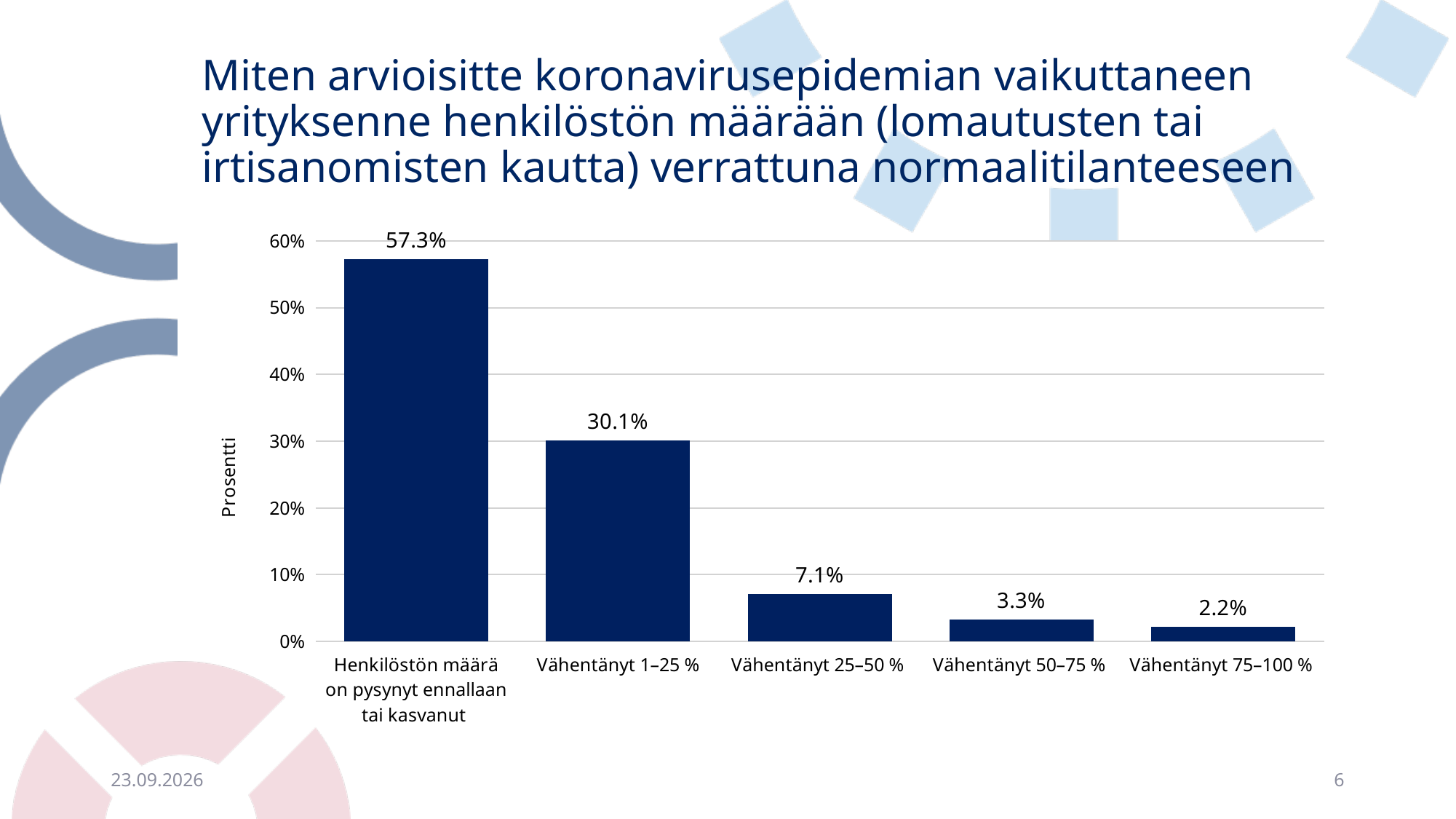
What is the label of the vertical axis? Prosentti What is the value for "Vähentänyt 1–25 %"? 30.1% Which category has the lowest value? Vähentänyt 75–100 % What is the value for "Henkilöstön määrä on pysynyt ennallaan tai kasvanut"? 57.3% Which category has the highest value? Henkilöstön määrä on pysynyt ennallaan tai kasvanut What is the value for "Vähentänyt 25–50 %"? 7.1% Is the value for "Vähentänyt 1–25 %" greater or less than 40%? less What is the value for "Vähentänyt 75–100 %"? 2.2% What kind of chart is shown on the slide? bar chart How many categories are shown in the chart? 5 Which is larger, the value for "Vähentänyt 50–75 %" or "Vähentänyt 75–100 %"? Vähentänyt 50–75 % What is the difference between the values for "Vähentänyt 1–25 %" and "Vähentänyt 25–50 %"? 23.0%